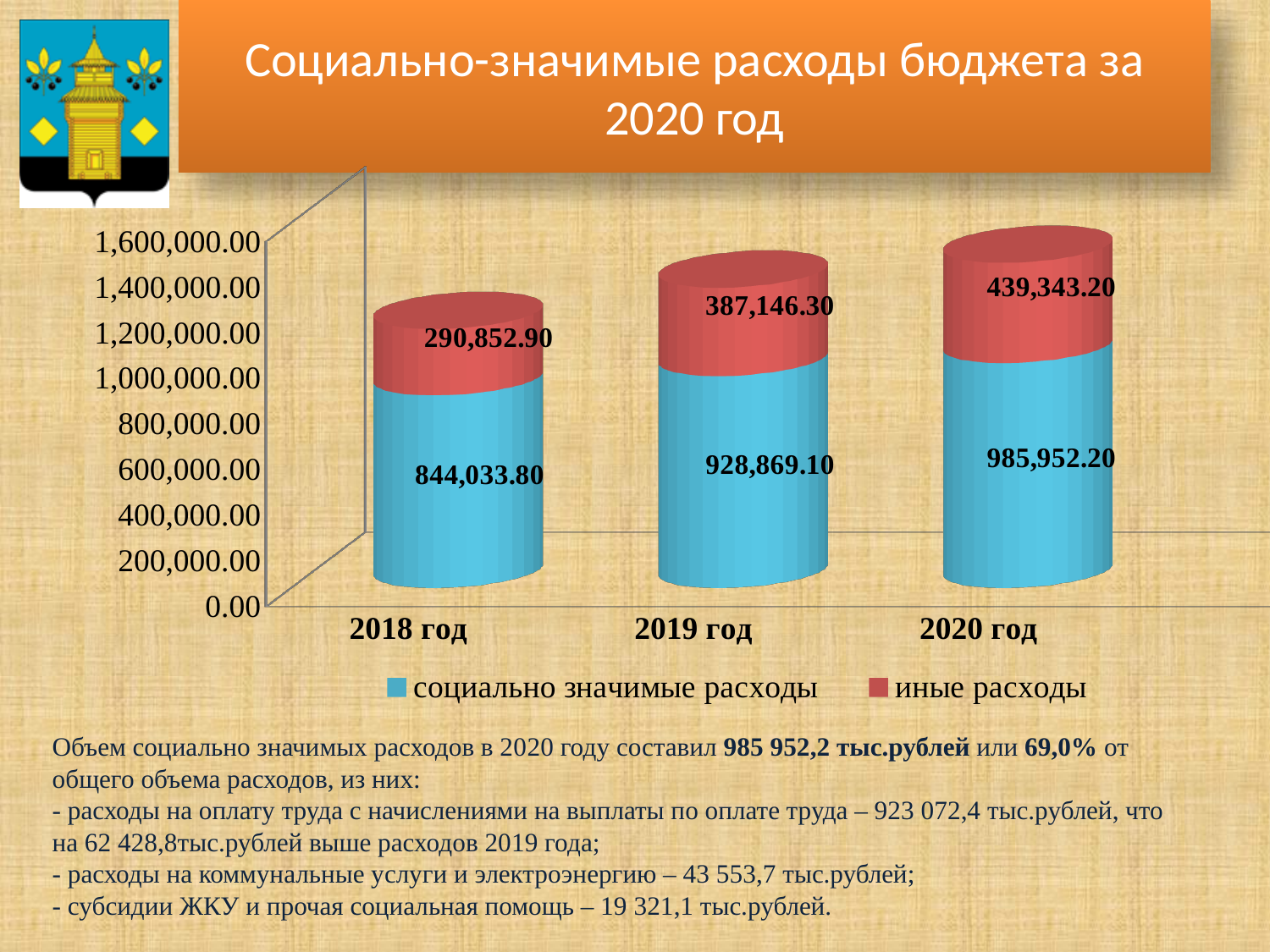
Which is larger: социально значимые расходы in 2019 год or in 2020 год? 2020 год What is the difference between иные расходы in 2019 год and 2018 год? 96,293.40 What is the value of социально значимые расходы for 2020 год? 985,952.20 What is the value of социально значимые расходы for 2019 год? 928,869.10 Which year has the lowest value for социально значимые расходы? 2018 год Do the values for социально значимые расходы rise or fall from 2018 год to 2020 год? rise What is the total of the stacked bar for 2018 год? 1,134,886.70 How many series does the legend list? 2 What is the total of the stacked bar for 2020 год? 1,425,295.40 What is the difference between социально значимые расходы in 2020 год and 2018 год? 141,918.40 What is the value of иные расходы for 2018 год? 290,852.90 Which year has the highest value for иные расходы? 2020 год